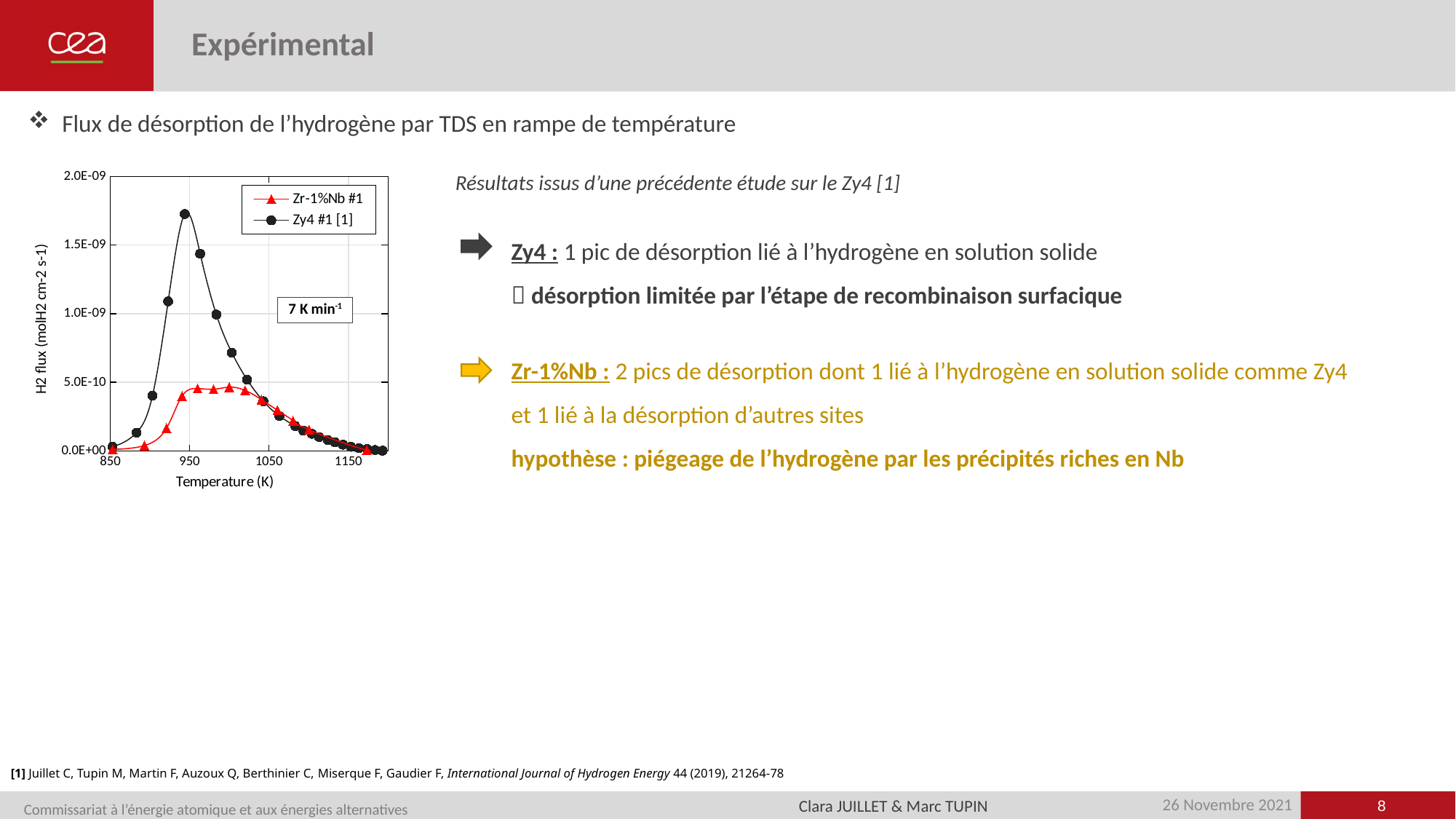
Is the peak H2 flux of the Zr-1%Nb #1 series greater or less than 1.0E-09? less Which series reaches the higher peak H2 flux, Zr-1%Nb #1 or Zy4 #1 [1]? Zy4 #1 [1] Around which x-axis tick does the Zy4 #1 [1] series reach its maximum? 950 Is the H2 flux of the Zy4 #1 [1] series at 1050 K greater or less than 5.0E-10? less What heating rate is annotated on the chart? 7 K min-1 How many series does the chart legend list? 2 What kind of chart is shown on the slide? Line chart Is the peak H2 flux of the Zy4 #1 [1] series greater or less than 1.5E-09? greater Does the H2 flux of the Zy4 #1 [1] series rise or fall between 850 K and 950 K? rise What is the label of the x axis of the chart? Temperature (K) Does the H2 flux of the Zy4 #1 [1] series rise or fall between 950 K and 1150 K? fall